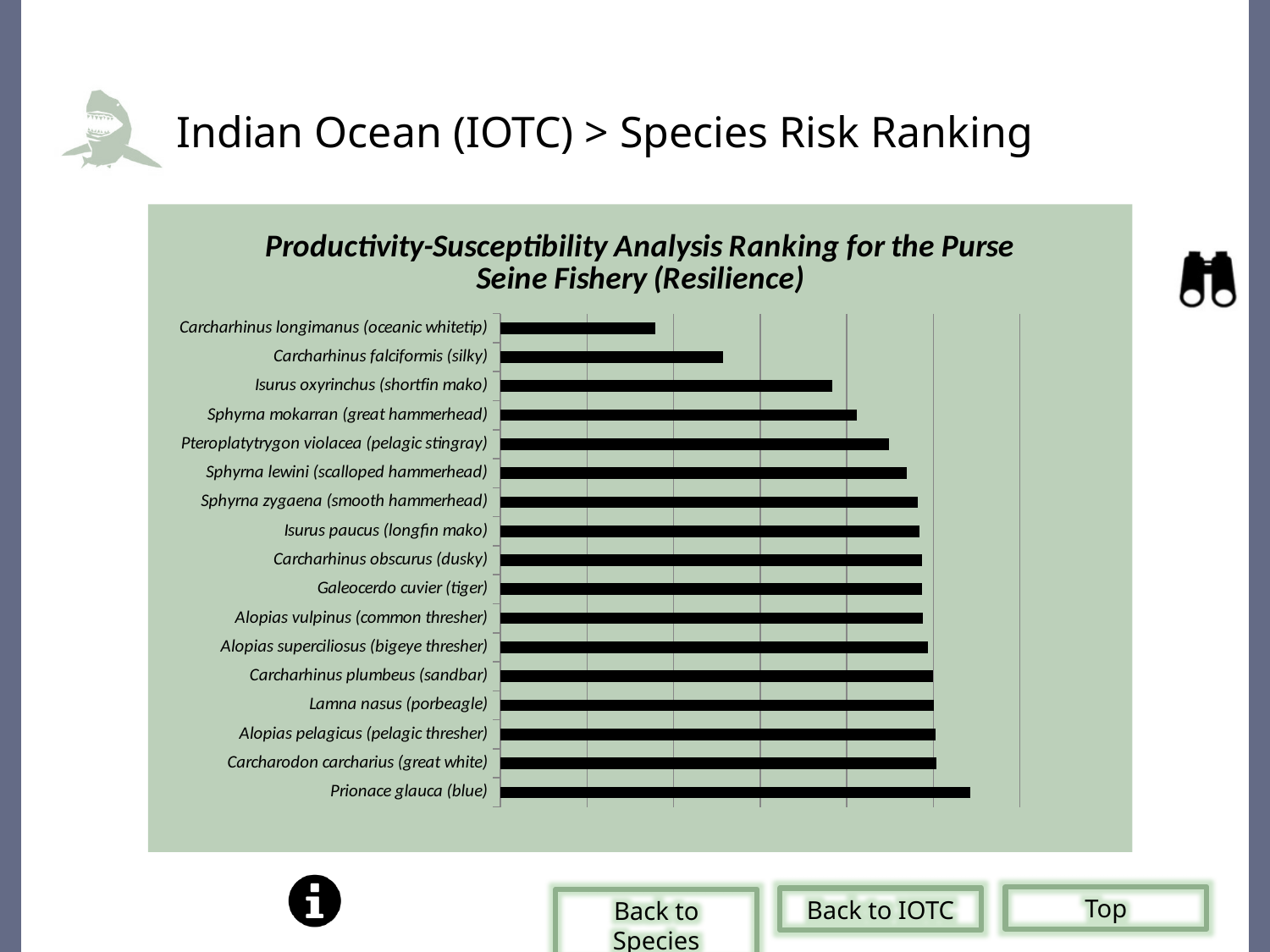
Which species has the shortest bar in the chart? Carcharhinus longimanus (oceanic whitetip) Which species has the longest bar in the chart? Prionace glauca (blue) What kind of chart is shown on the slide? bar chart Which has the longer bar, Sphyrna mokarran (great hammerhead) or Isurus oxyrinchus (shortfin mako)? Sphyrna mokarran (great hammerhead) Which species is listed at the top of the chart? Carcharhinus longimanus (oceanic whitetip) What is the title of the chart? Productivity-Susceptibility Analysis Ranking for the Purse Seine Fishery (Resilience) Which has the longer bar, Carcharhinus falciformis (silky) or Isurus oxyrinchus (shortfin mako)? Isurus oxyrinchus (shortfin mako) Going from the top of the chart to the bottom, do the bars generally get longer or shorter? longer Which has the longer bar, Carcharhinus longimanus (oceanic whitetip) or Prionace glauca (blue)? Prionace glauca (blue) How many species are listed in the chart? 17